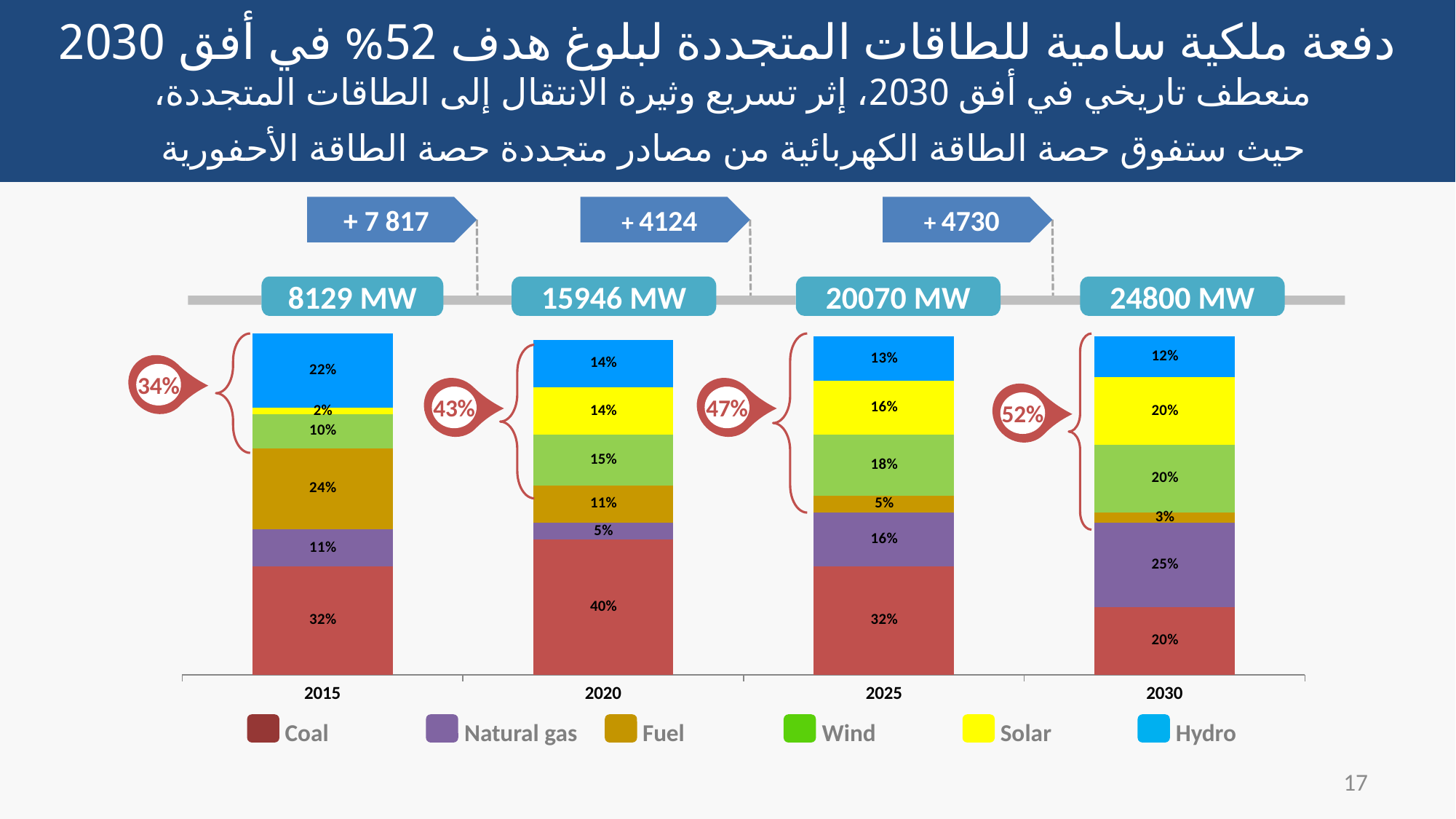
In which year is the Fuel share highest? 2015 What kind of chart is shown on the slide? Stacked bar chart How many years are shown on the x axis of the chart? 4 How many series does the legend list? 6 What is the Hydro share in 2025? 13% What is the difference between the Wind share in 2030 and in 2015? 10% Does the Fuel share rise or fall from 2015 to 2030? Fall In which year is the Coal share lowest? 2030 What is the Solar share in 2015? 2% Which is larger in 2025: the Natural gas share or the Fuel share? Natural gas What is the Natural gas share in 2030? 25% What is the Coal share in 2020? 40%